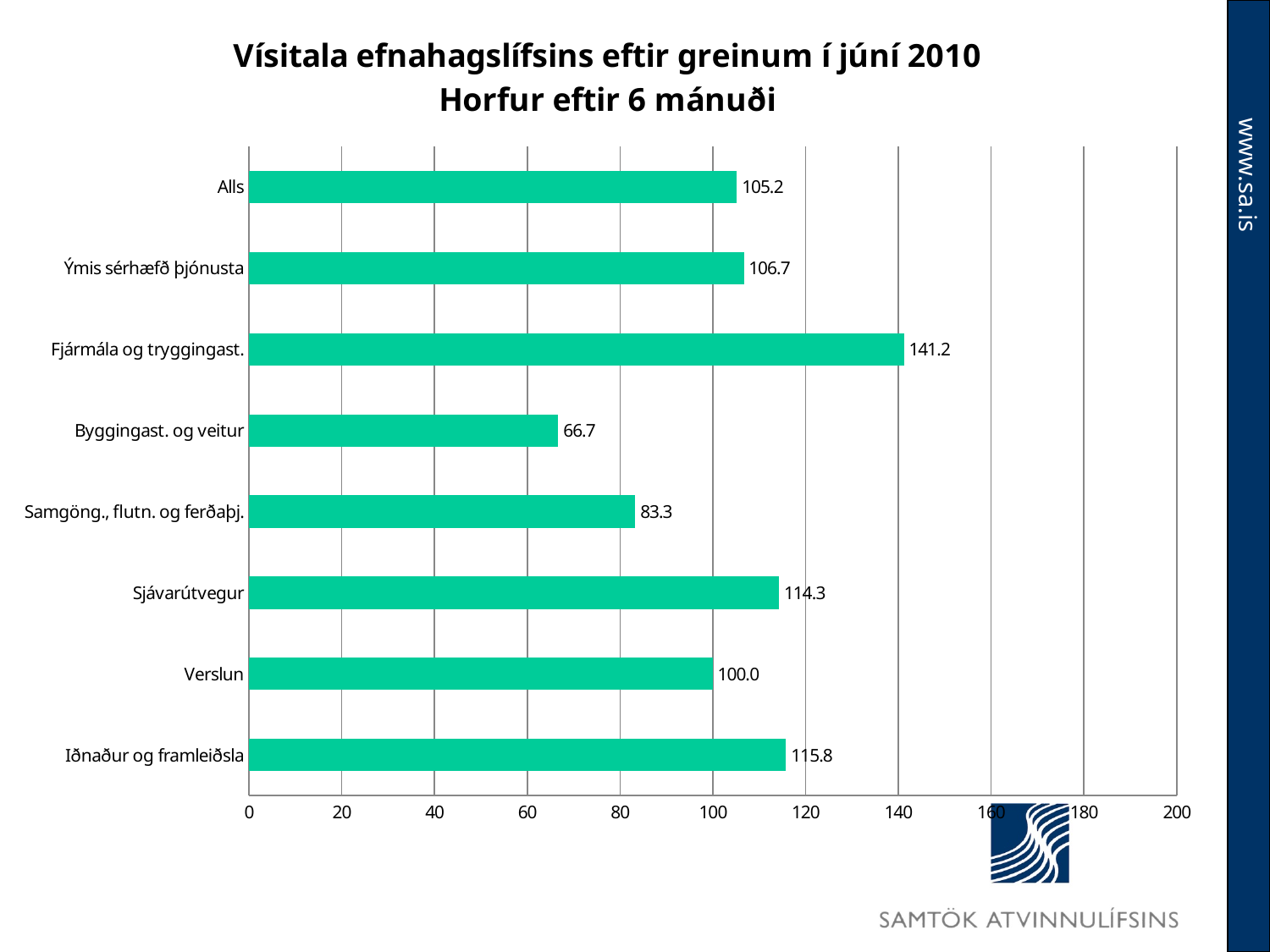
Which is larger, the value for Sjávarútvegur or the value for Samgöng., flutn. og ferðaþj.? Sjávarútvegur What is the difference between the values for Iðnaður og framleiðsla and Verslun? 15.8 What is the second line of the chart title? Horfur eftir 6 mánuði What kind of chart is shown on the slide? bar chart Which category has the highest value? Fjármála og tryggingast. Is the value for Samgöng., flutn. og ferðaþj. greater or less than 100? less How many categories are shown in the chart? 8 What is the value for Ýmis sérhæfð þjónusta? 106.7 What is the value for Fjármála og tryggingast.? 141.2 What is the value for Byggingast. og veitur? 66.7 Which category has the lowest value? Byggingast. og veitur What is the value for Alls? 105.2